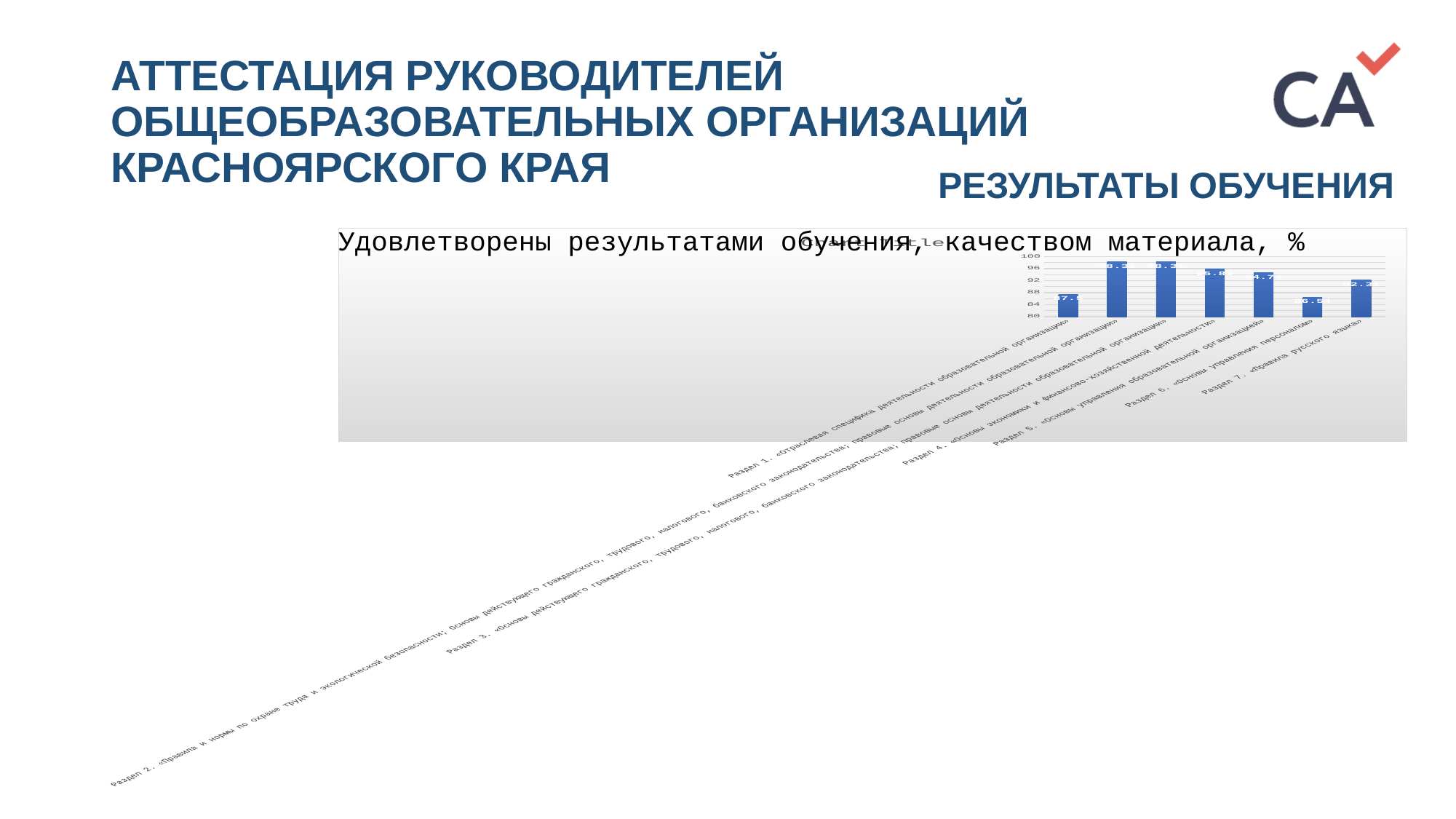
What kind of chart is shown on the slide? bar chart Is the value for Раздел 6 («Основы управления персоналом») greater or less than 88? less What is the title of the chart? Удовлетворены результатами обучения, качеством материала, % What is the lowest value shown on the vertical axis of the chart? 80 Is the value for Раздел 5 greater or less than 92? greater Which has the larger value, Раздел 5 or Раздел 7? Раздел 5 Which has the larger value, Раздел 2 or Раздел 6? Раздел 2 Is the value for Раздел 3 greater or less than 96? greater How many bars (categories) does the chart show? 7